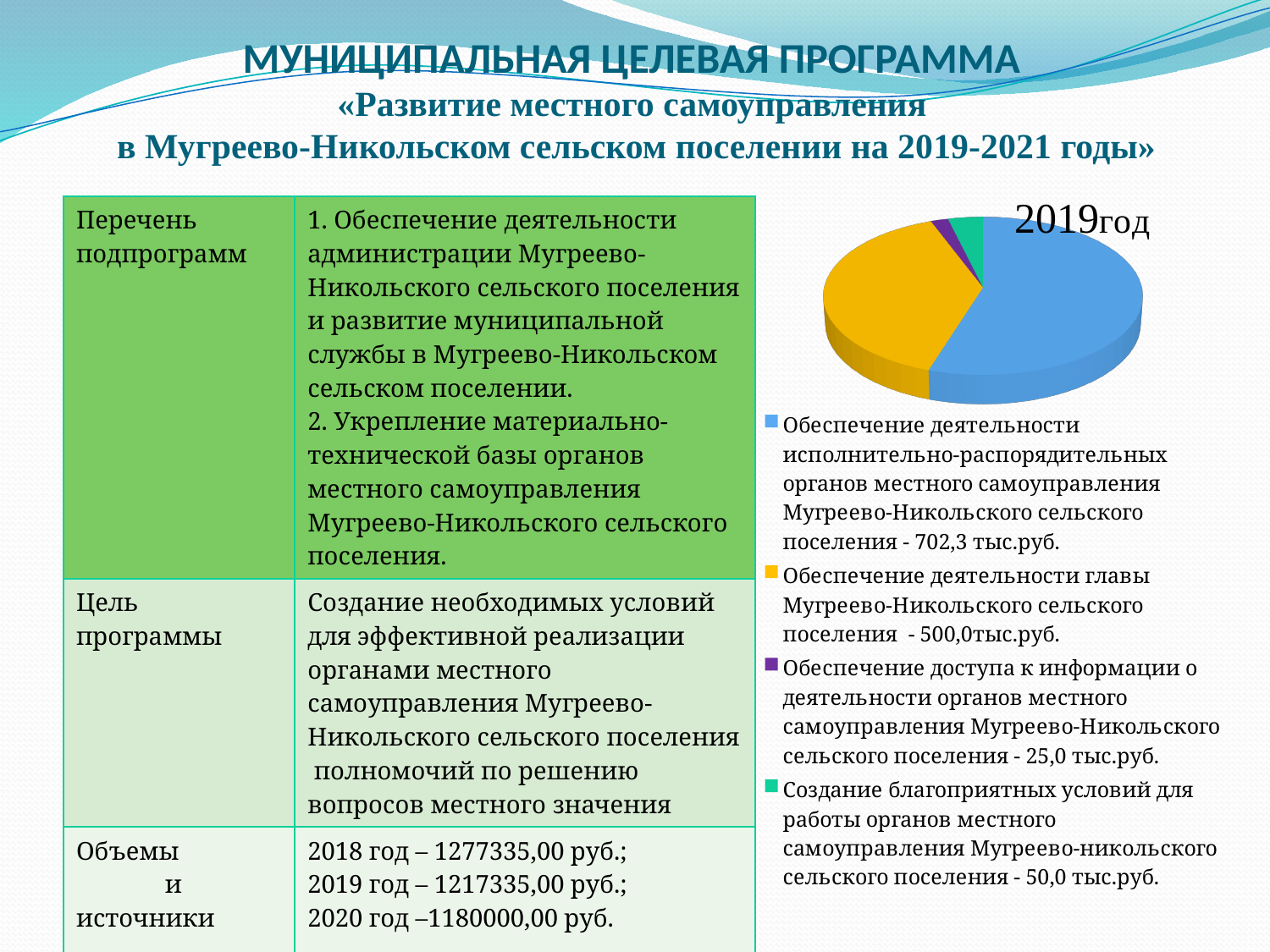
How many entries does the legend of the pie chart list? 4 What is the value for «Обеспечение деятельности исполнительно-распорядительных органов местного самоуправления Мугреево-Никольского сельского поселения»? 702,3 тыс.руб. What is the difference between the value for «Обеспечение деятельности исполнительно-распорядительных органов» and the value for «Обеспечение деятельности главы»? 202,3 тыс.руб. Which category has the largest slice of the pie chart? Обеспечение деятельности исполнительно-распорядительных органов местного самоуправления What is the title of the pie chart? 2019год Which is larger: the value for «Обеспечение деятельности главы» or the value for «Создание благоприятных условий для работы органов местного самоуправления»? Обеспечение деятельности главы Which category has the smallest slice of the pie chart? Обеспечение доступа к информации о деятельности органов местного самоуправления What is the value for «Обеспечение доступа к информации о деятельности органов местного самоуправления»? 25,0 тыс.руб. How many slices does the pie chart have? 4 What kind of chart is shown on the slide? Pie chart What is the value for «Обеспечение деятельности главы Мугреево-Никольского сельского поселения»? 500,0 тыс.руб. What is the value for «Создание благоприятных условий для работы органов местного самоуправления»? 50,0 тыс.руб.